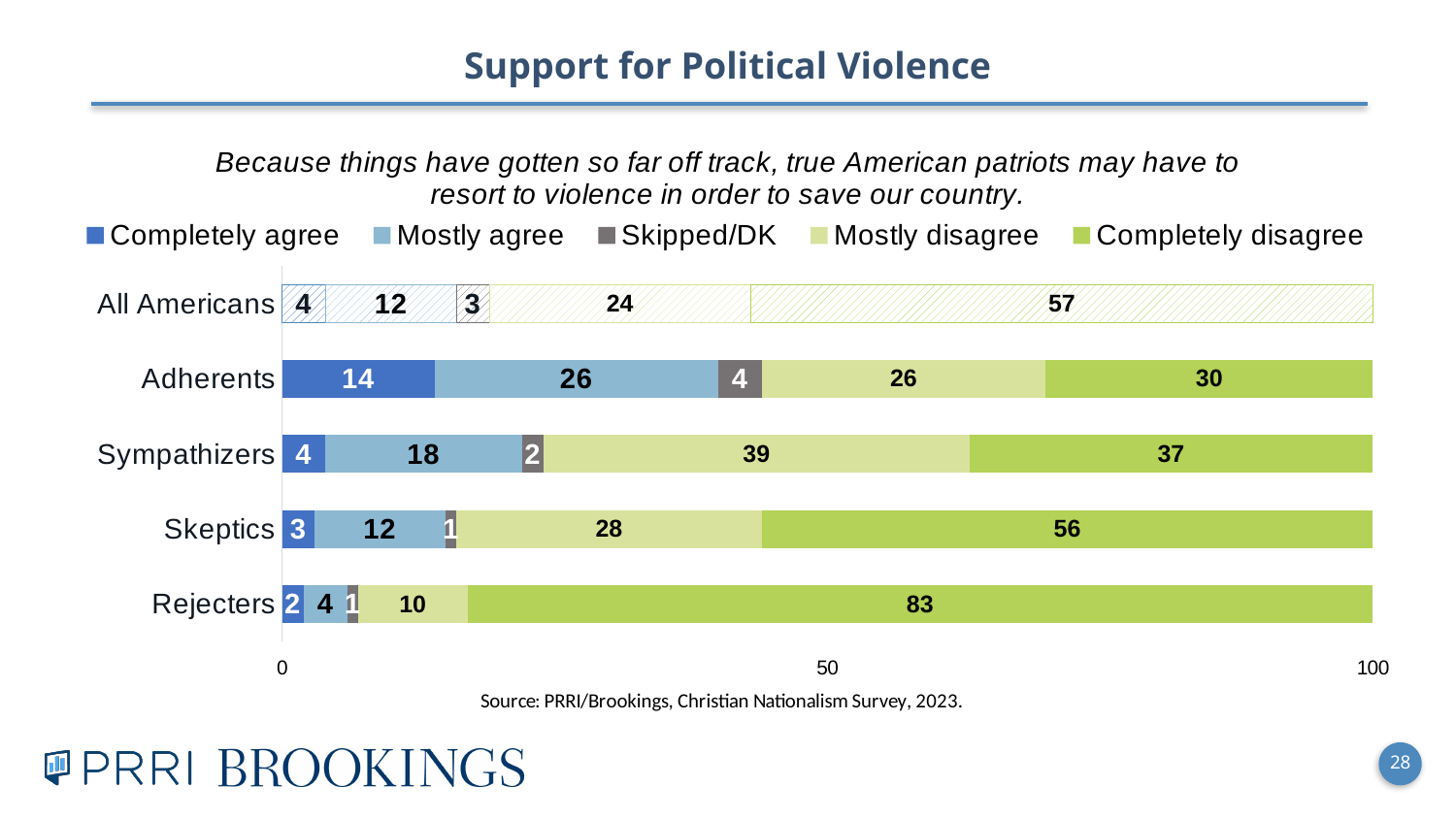
Which group has the lowest Completely disagree value? Adherents What is the Mostly agree value for Adherents? 26 How much larger is the Completely disagree value for Rejecters than for Skeptics? 27 Which group has a larger Mostly agree value, Sympathizers or Skeptics? Sympathizers What is the Mostly disagree value for Sympathizers? 39 Which group has the highest Completely agree value? Adherents How many groups are shown on the chart? 5 What is the total of the stacked bar for Adherents? 100 Is the Completely disagree value for All Americans greater or less than 50? greater How many series does the legend list? 5 What kind of chart is shown on the slide? Stacked bar chart What percentage of Rejecters completely disagree with the statement? 83